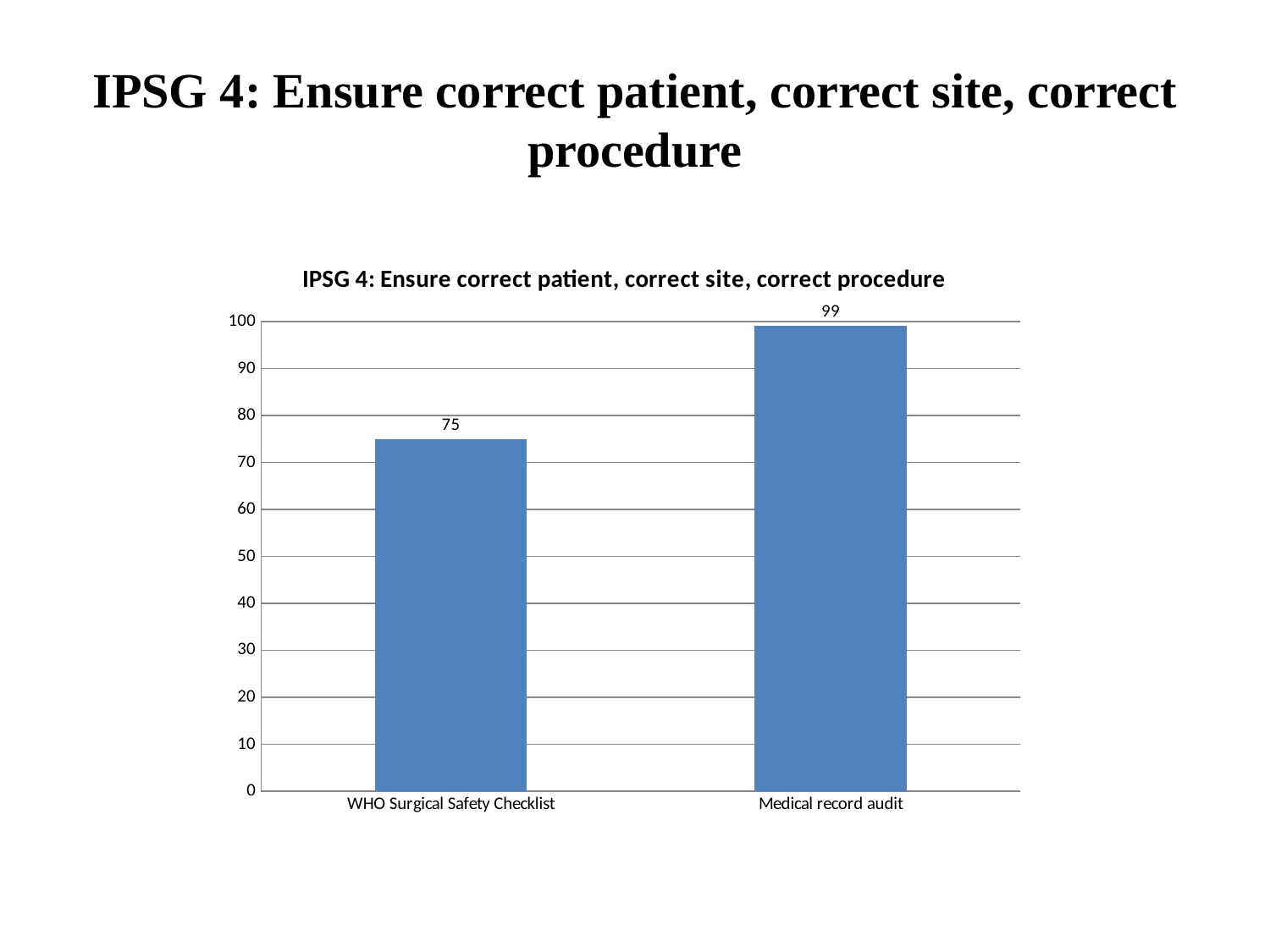
What is the value for Medical record audit? 99 How many categories are shown on the x axis? 2 Which is larger, the value for WHO Surgical Safety Checklist or the value for Medical record audit? Medical record audit What is the value for WHO Surgical Safety Checklist? 75 Is the value for WHO Surgical Safety Checklist greater or less than 80? less What kind of chart is shown on the slide? bar chart What is the title of the chart? IPSG 4: Ensure correct patient, correct site, correct procedure What is the maximum value shown on the y axis? 100 Which category has the highest value? Medical record audit What is the difference between the values for Medical record audit and WHO Surgical Safety Checklist? 24 Is the value for Medical record audit greater or less than 90? greater Which category has the lowest value? WHO Surgical Safety Checklist